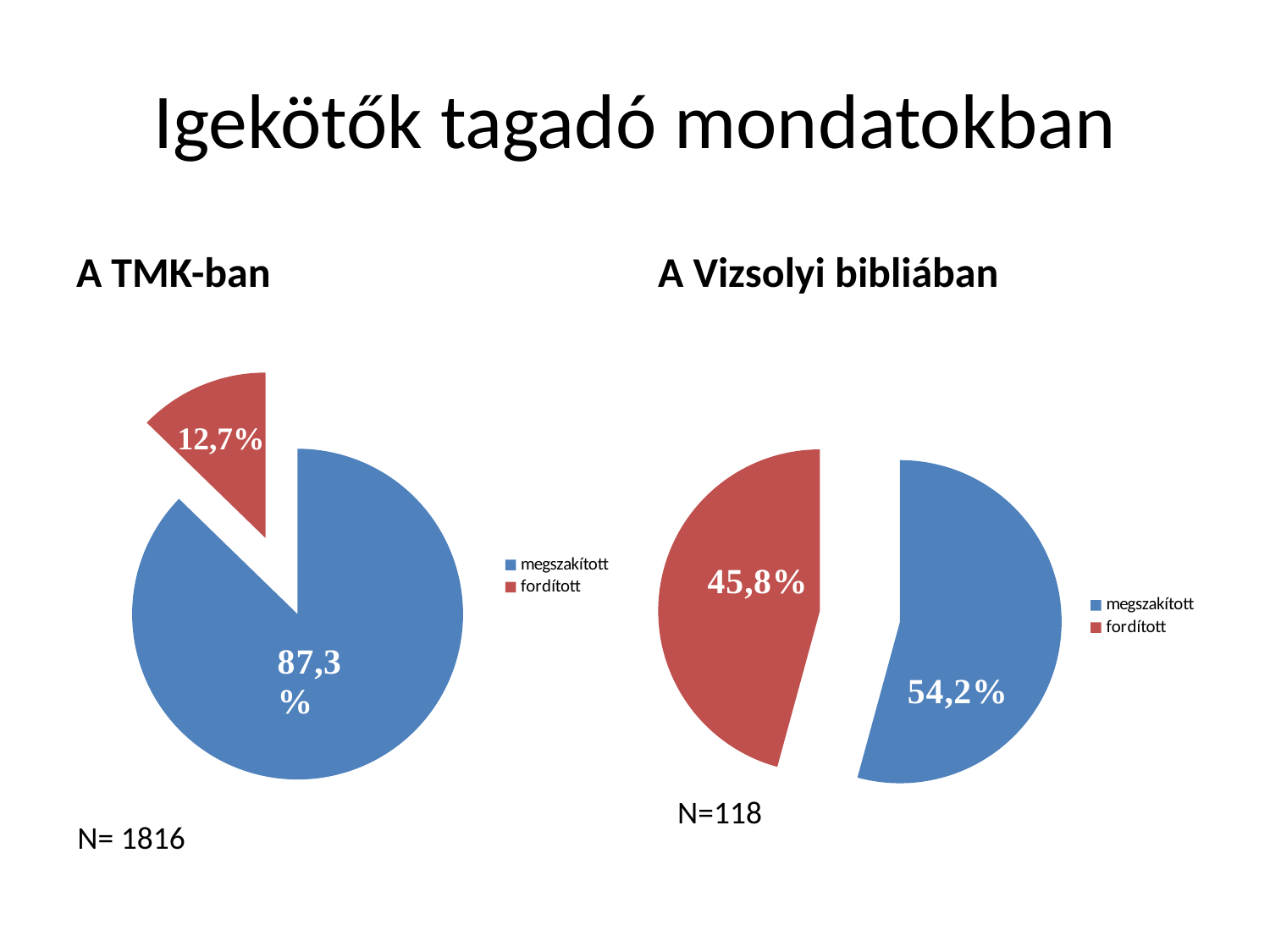
In the right pie chart (A Vizsolyi bibliában), which category has the smallest slice? fordított In the left pie chart (A TMK-ban), what is the difference in percentage points between the 'megszakított' and 'fordított' slices? 74,6 In the right pie chart (A Vizsolyi bibliában), what is the difference in percentage points between the 'megszakított' and 'fordított' slices? 8,4 In the left pie chart (A TMK-ban), which category has the largest slice? megszakított In the right pie chart (A Vizsolyi bibliában), what share does the 'fordított' slice have? 45,8% How many categories does the legend of the right pie chart (A Vizsolyi bibliában) list? 2 What kind of chart is used on the left (A TMK-ban)? pie chart Which chart has the larger 'fordított' share, the left one (A TMK-ban) or the right one (A Vizsolyi bibliában)? A Vizsolyi bibliában In the right pie chart (A Vizsolyi bibliában), what share does the 'megszakított' slice have? 54,2% In the left pie chart (A TMK-ban), what share does the 'megszakított' slice have? 87,3% What colour is the 'fordított' slice in the left pie chart (A TMK-ban)? red